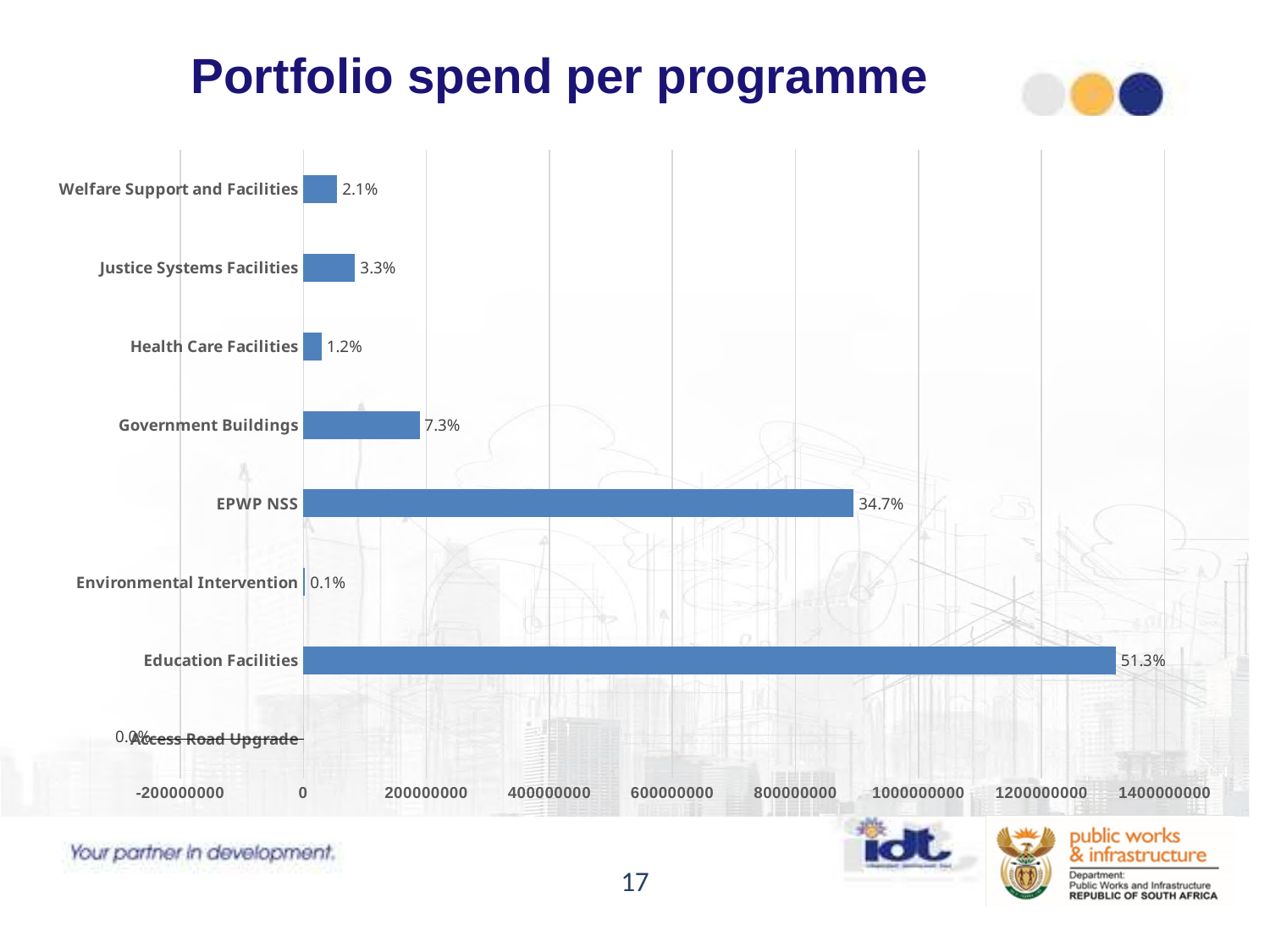
What type of chart is shown on the slide? Bar chart What is the difference in percentage points between Education Facilities and EPWP NSS? 16.6% How many programmes are listed on the chart? 8 What is the data label shown for EPWP NSS? 34.7% What is the data label shown for Health Care Facilities? 1.2% Which programme has the highest share of portfolio spend? Education Facilities What is the data label shown for Government Buildings? 7.3% Is the bar for Education Facilities greater or less than 1200000000 on the x axis? greater Which programme has the lowest share of portfolio spend? Access Road Upgrade What is the difference in percentage points between Justice Systems Facilities and Welfare Support and Facilities? 1.2% Is the bar for EPWP NSS greater or less than 1000000000 on the x axis? less Which has a larger share of spend, Government Buildings or Justice Systems Facilities? Government Buildings